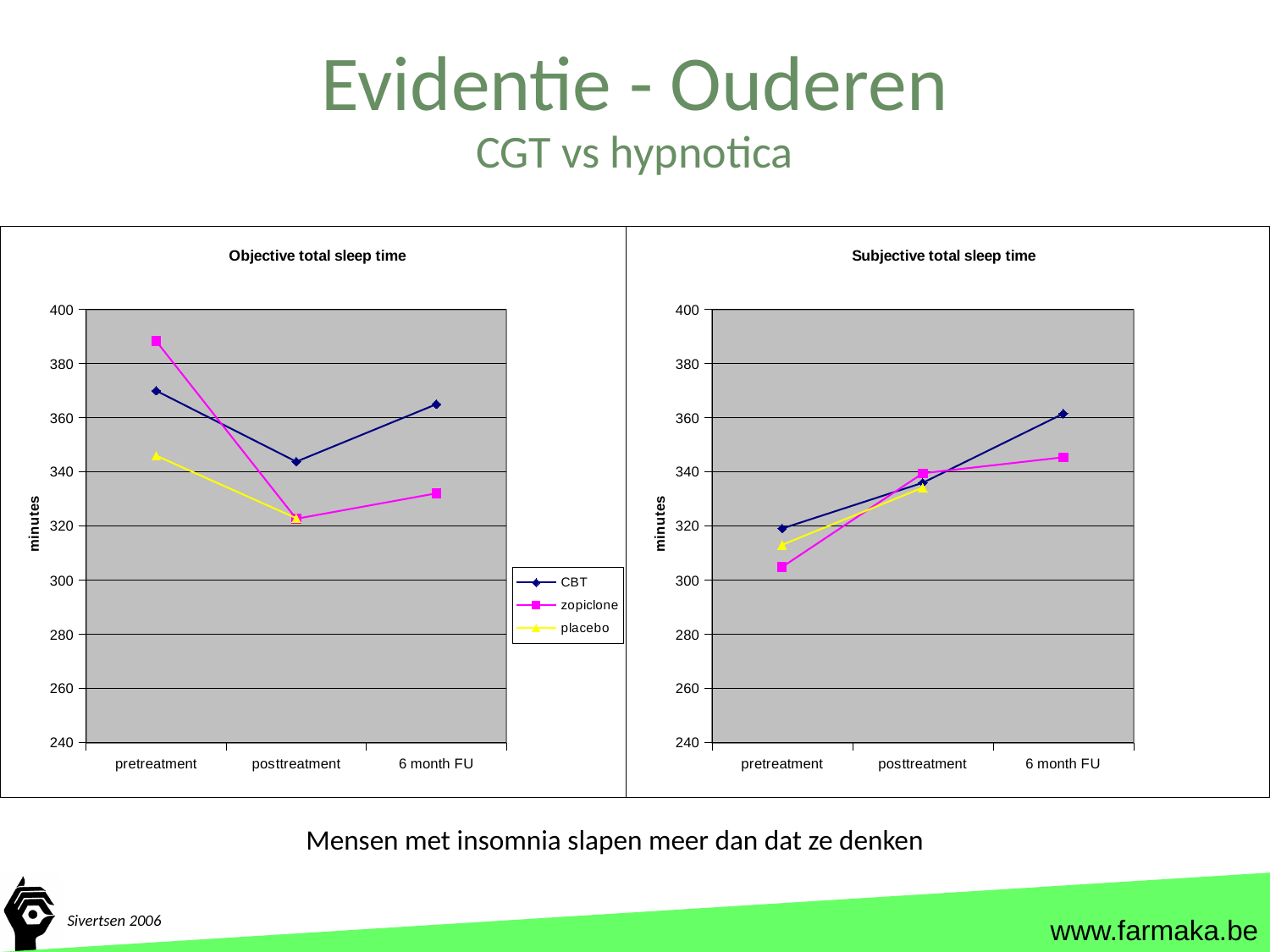
How many series does the legend list? 3 In the "Subjective total sleep time" chart, does the CBT series rise or fall from pretreatment to 6 month FU? rise In the "Subjective total sleep time" chart, which series has the lowest value at pretreatment? zopiclone How many time points are shown on the x axis of the "Subjective total sleep time" chart? 3 In the "Subjective total sleep time" chart, which series has the highest value at 6 month FU? CBT In the "Objective total sleep time" chart, is the value for zopiclone at pretreatment greater or less than 380? greater In the "Objective total sleep time" chart, is the value for zopiclone at 6 month FU greater or less than 340? less What kind of chart is the "Objective total sleep time" chart? line chart In the "Objective total sleep time" chart, which series has the highest value at pretreatment? zopiclone In the "Objective total sleep time" chart, does the zopiclone series rise or fall from pretreatment to posttreatment? fall In the "Objective total sleep time" chart, which series has the lowest value at pretreatment? placebo In the "Subjective total sleep time" chart, is the value for zopiclone at pretreatment greater or less than 320? less